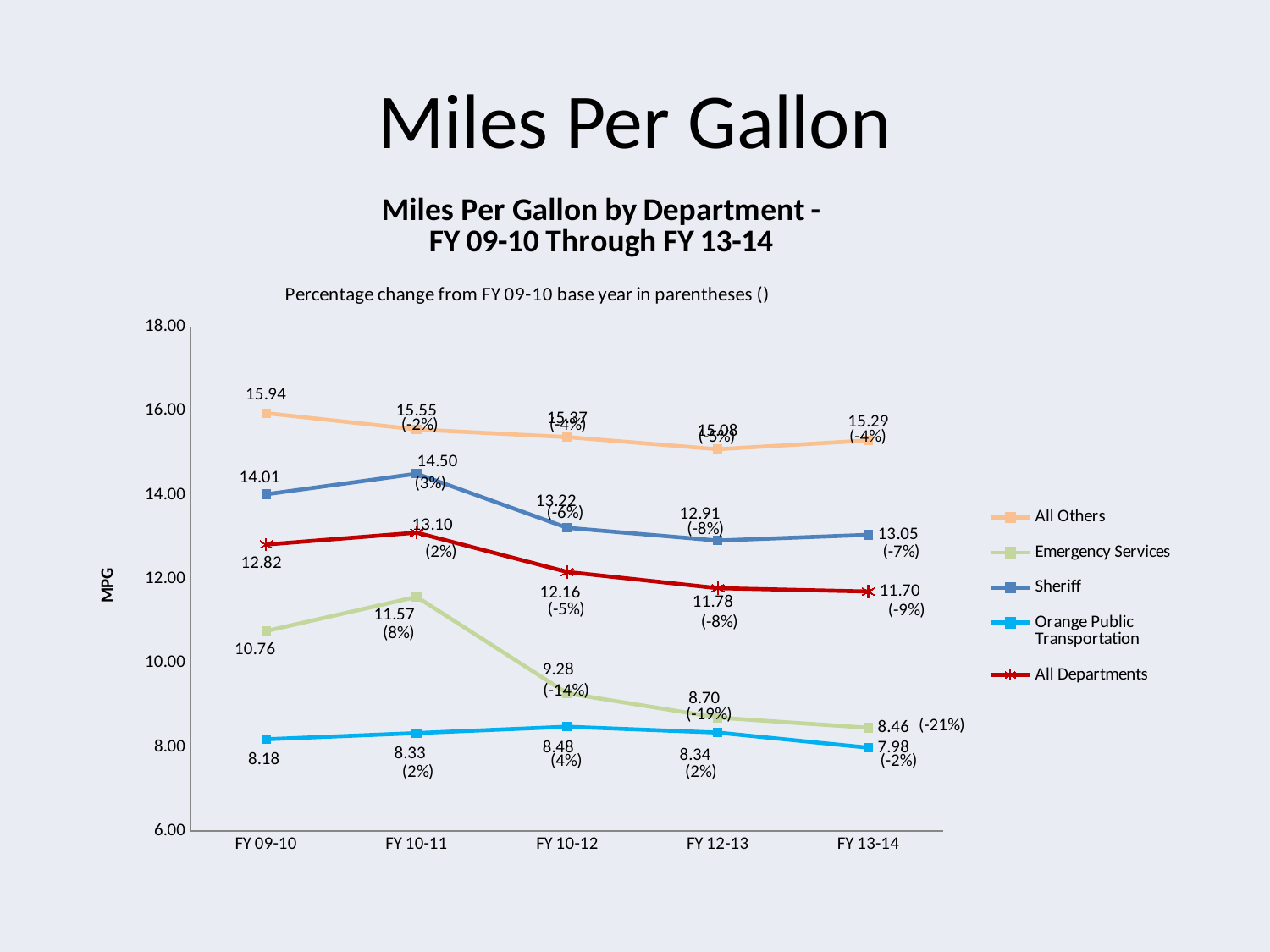
In FY 10-11, which is larger: the MPG for Emergency Services or for Orange Public Transportation? Emergency Services What is the MPG value for Emergency Services in FY 13-14? 8.46 What kind of chart is this? Line chart What is the MPG value for Sheriff in FY 10-11? 14.50 How many series does the legend list? 5 Which series has the lowest MPG in FY 13-14? Orange Public Transportation What is the difference between the Sheriff MPG in FY 09-10 and in FY 13-14? 0.96 How many fiscal years are shown on the x axis? 5 What is the MPG value for Orange Public Transportation in FY 10-12? 8.48 What is the MPG value for All Others in FY 09-10? 15.94 What percentage change from the base year is shown for Emergency Services in FY 13-14? -21% Which series has the highest MPG in FY 09-10? All Others